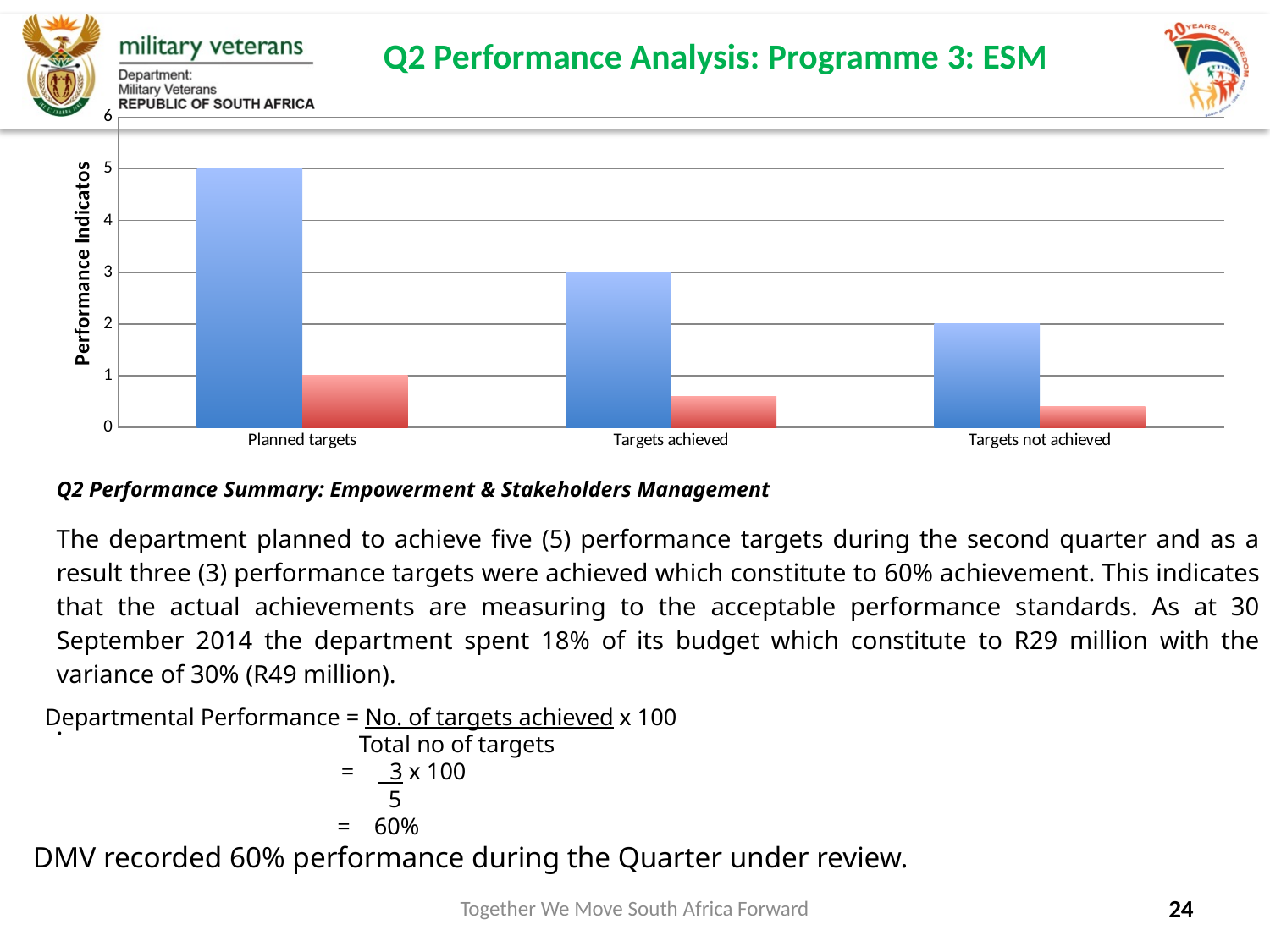
How many categories are shown on the x axis of the chart? 3 Do the blue bars rise or fall from left to right across the x axis? Fall Which category has the highest blue bar? Planned targets Which category has the lowest blue bar? Targets not achieved Is the red bar for Targets achieved greater or less than 1? less What is the value of the blue bar for Targets achieved? 3 What is the value of the blue bar for Targets not achieved? 2 What is the value of the blue bar for Planned targets? 5 What kind of chart is shown on the slide? Bar chart What is the difference between the blue bars for Planned targets and Targets achieved? 2 What is the value of the red bar for Planned targets? 1 What is the label on the y axis of the chart? Performance Indicatos